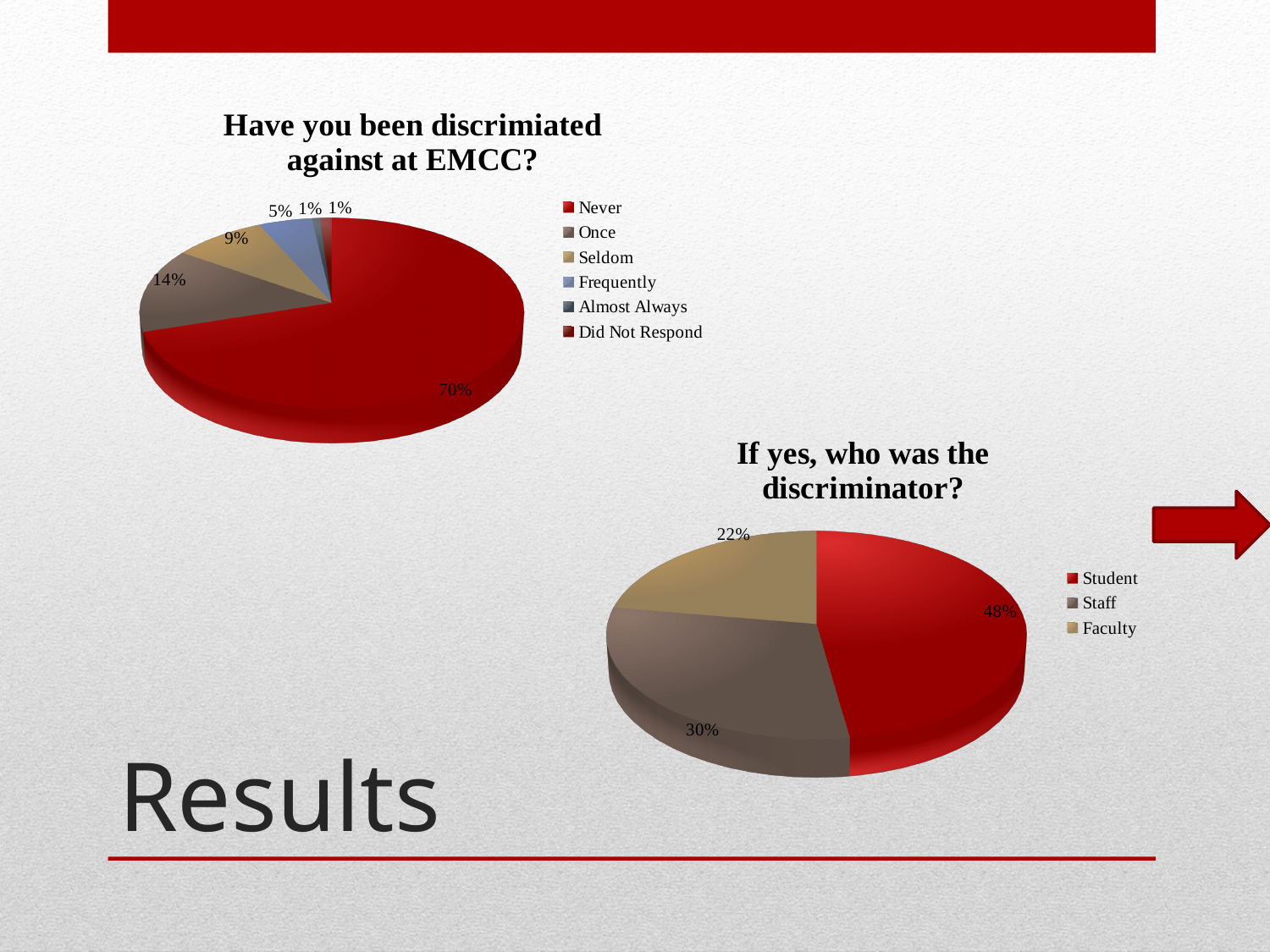
In the chart titled "Have you been discrimiated against at EMCC?", what is the difference between the Once and Seldom shares? 5% In the chart titled "Have you been discrimiated against at EMCC?", what percentage answered Once? 14% In the chart titled "Have you been discrimiated against at EMCC?", which response has the largest share? Never In the chart titled "Have you been discrimiated against at EMCC?", how many categories does the legend list? 6 What type of chart is used for "If yes, who was the discriminator?"? Pie chart In the chart titled "If yes, who was the discriminator?", which category has the smallest share? Faculty In the chart titled "Have you been discrimiated against at EMCC?", what percentage answered Seldom? 9% In the chart titled "If yes, who was the discriminator?", which is larger, Student or Staff? Student In the chart titled "If yes, who was the discriminator?", what share is attributed to Staff? 30% In the chart titled "Have you been discrimiated against at EMCC?", what percentage of respondents answered Never? 70% In the chart titled "If yes, who was the discriminator?", what colour represents Faculty? Tan In the chart titled "If yes, who was the discriminator?", what is the difference between the Student and Faculty shares? 26%